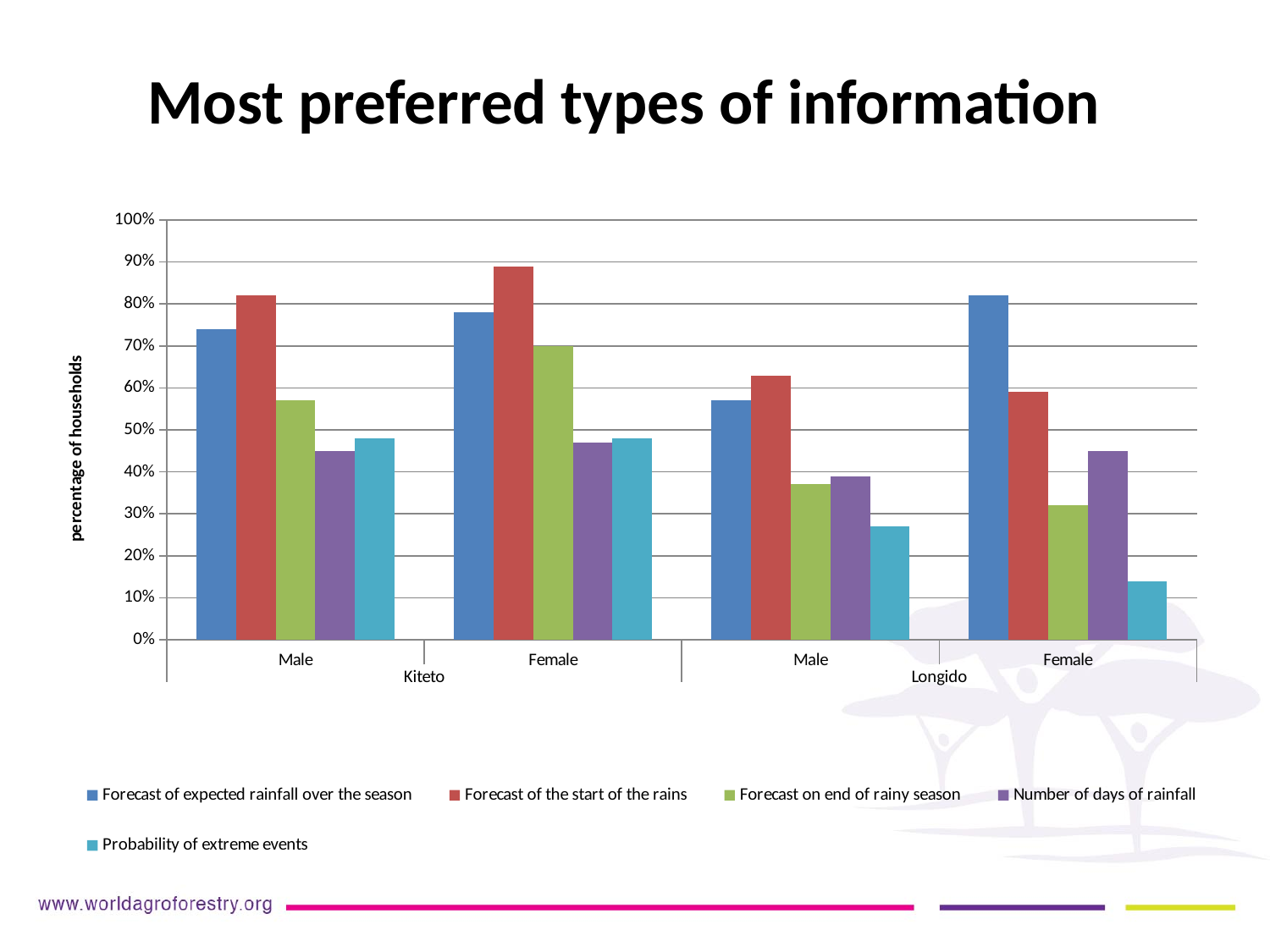
For Kiteto Female, which type of information has the highest bar? Forecast of the start of the rains For Longido Male, which is larger: Forecast of expected rainfall over the season or Forecast of the start of the rains? Forecast of the start of the rains Is the value for Probability of extreme events for Longido Female greater or less than 20%? less How many category groups (gender-by-district) are plotted along the x axis? 4 Which group has the highest value for Forecast of the start of the rains? Kiteto Female Is the value for Forecast on end of rainy season for Kiteto Female greater or less than 60%? greater What kind of chart is shown on the slide? bar chart For Longido Female, which is larger: Forecast of expected rainfall over the season or Forecast of the start of the rains? Forecast of expected rainfall over the season How many series does the legend list? 5 For Longido Female, which type of information has the lowest bar? Probability of extreme events What is the title of the slide? Most preferred types of information What is the label on the y axis? percentage of households